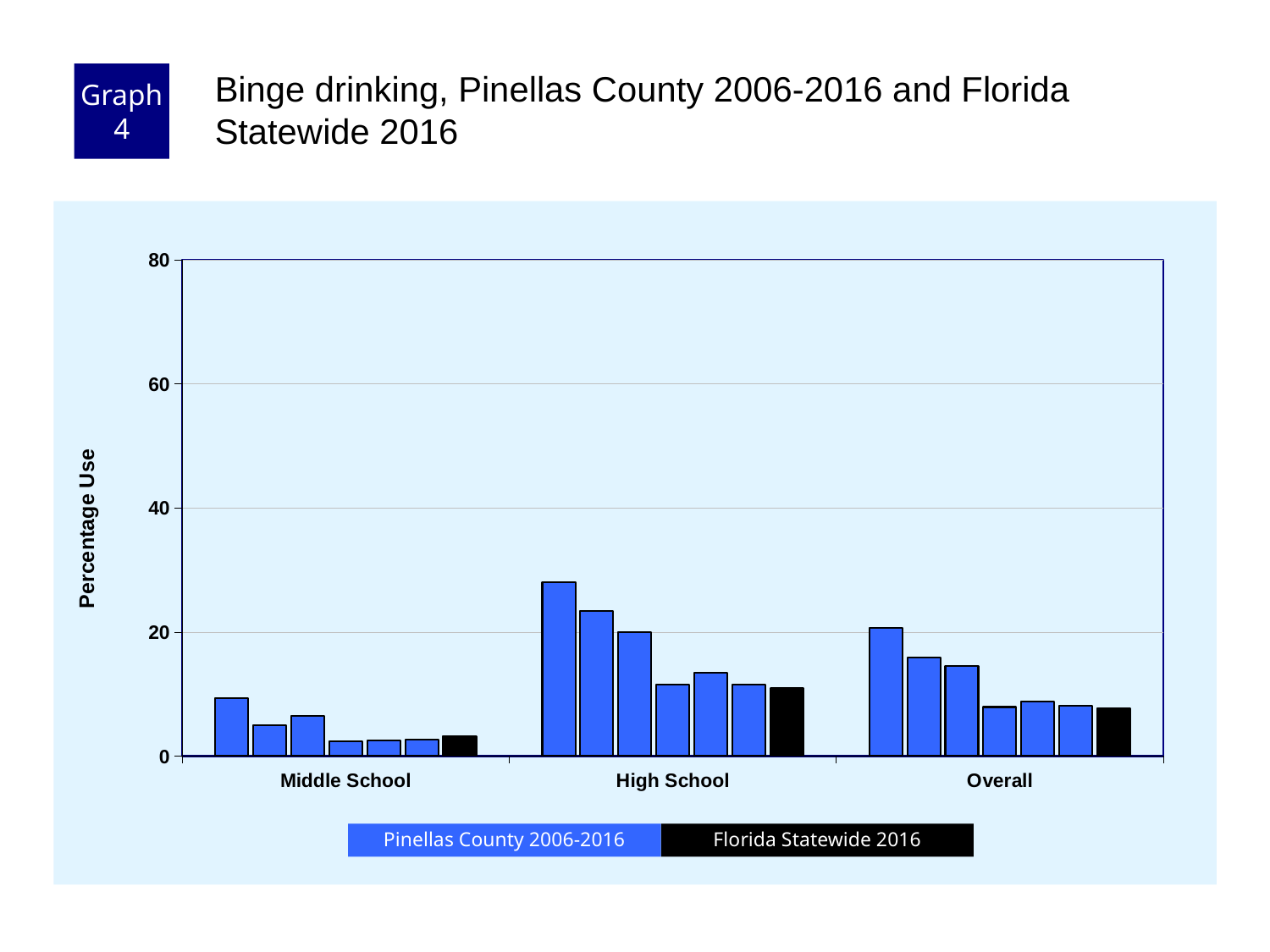
What is the label on the y axis? Percentage Use What is the title of the chart? Binge drinking, Pinellas County 2006-2016 and Florida Statewide 2016 Within the High School group, do the Pinellas County bars generally rise or fall from left to right? fall How many series does the legend list? 2 Which category has the tallest bar? High School Is the Florida Statewide 2016 value for High School greater or less than 20? less Which category has the lowest bars overall? Middle School Is the tallest Pinellas County bar for High School greater or less than 20? greater What kind of chart is shown on the slide? bar chart How many categories are shown along the x axis? 3 Is the Florida Statewide 2016 value for Middle School greater or less than 20? less Which is larger, the Florida Statewide 2016 value for High School or for Middle School? High School